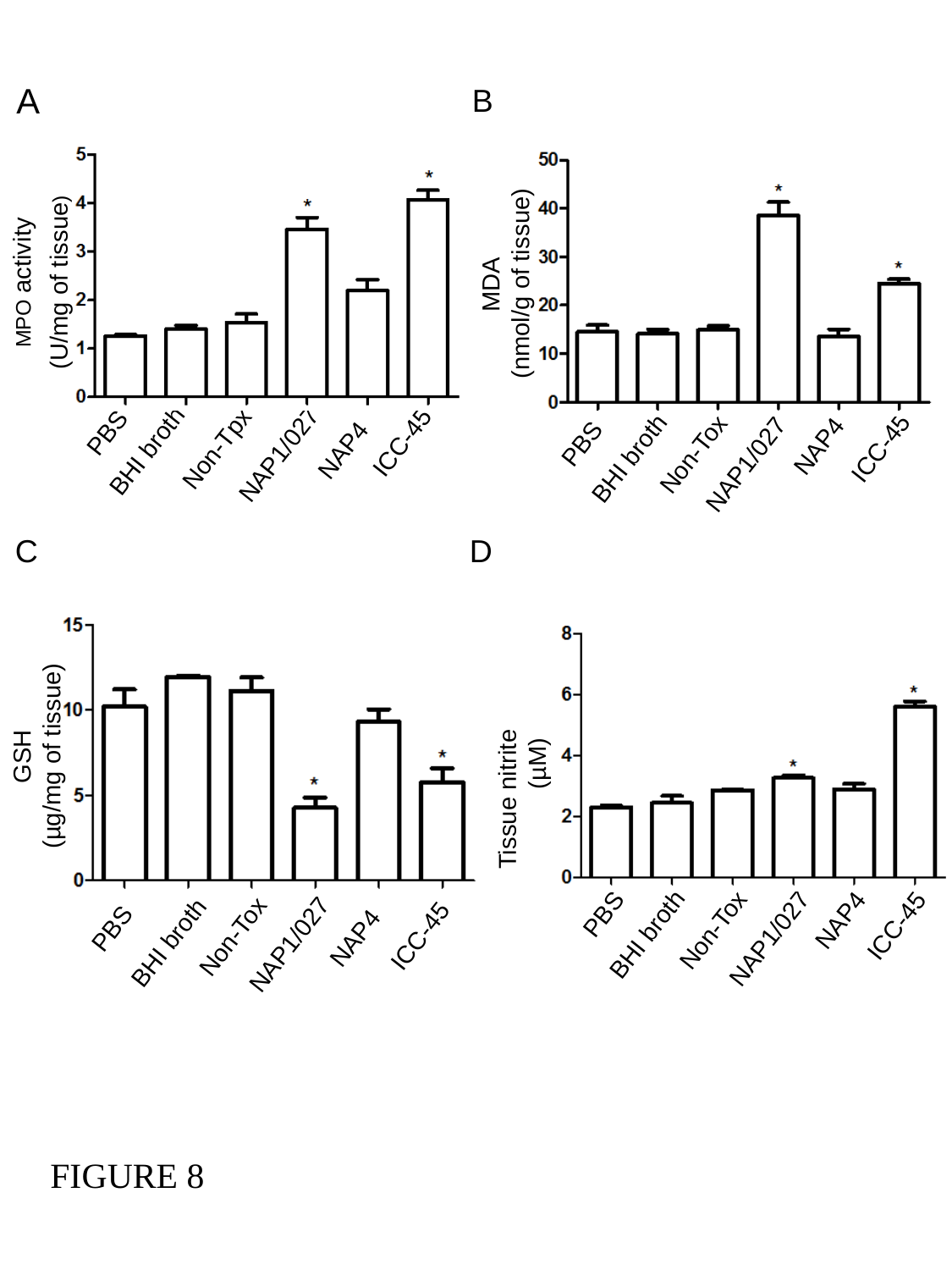
In chart D (Tissue nitrite), is the value for ICC-45 greater or less than 4? greater In chart A (MPO activity), is the value for NAP1/027 greater or less than 3? greater In chart B (MDA), which category has the highest value? NAP1/027 In chart C (GSH), which category has the lowest value? NAP1/027 In chart C (GSH), is the value for NAP4 greater or less than 10? less In chart A (MPO activity), which category has the highest value? ICC-45 In chart D (Tissue nitrite), which category has the highest value? ICC-45 In chart B (MDA), which is larger, the value for NAP1/027 or the value for ICC-45? NAP1/027 In chart A (MPO activity), which category has the lowest value? PBS How many categories are shown on the x axis of chart D (Tissue nitrite)? 6